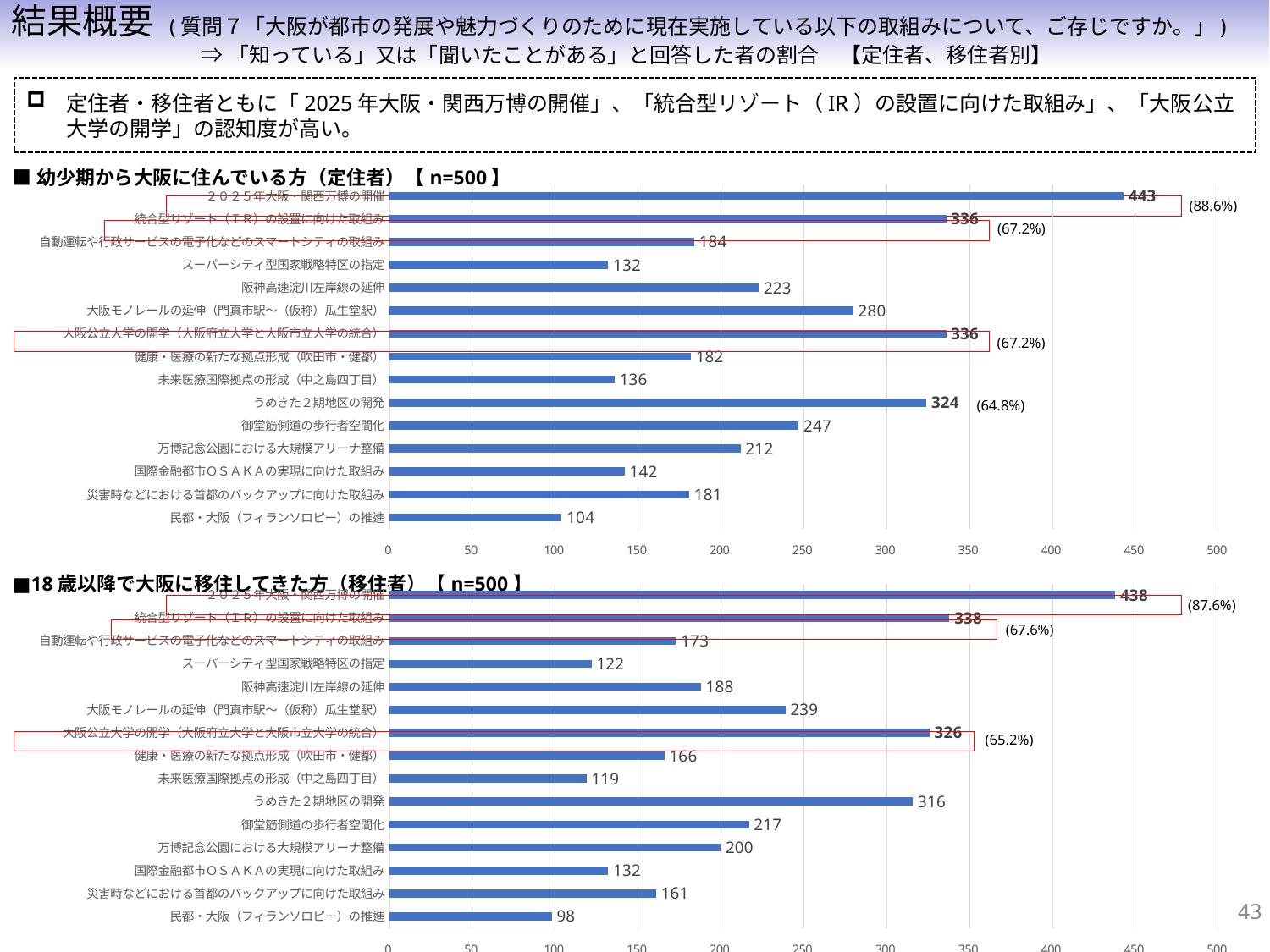
In the bottom chart (移住者), is the value for 万博記念公園における大規模アリーナ整備 greater or less than 150? greater What type of chart is used on this slide? Bar chart In the bottom chart (移住者), what is the value for 大阪公立大学の開学? 326 In the top chart (定住者), what is the difference between 大阪モノレールの延伸 (280) and 阪神高速淀川左岸線の延伸 (223)? 57 In the top chart (定住者), what is the value for 2025年大阪・関西万博の開催? 443 In the bottom chart (移住者), which category has the highest value? 2025年大阪・関西万博の開催 In the bottom chart (移住者), what is the value for 民都・大阪（フィランソロピー）の推進? 98 What percentage is shown next to the 2025年大阪・関西万博の開催 bar in the bottom chart (移住者)? (87.6%) In the top chart (定住者), how many categories are plotted? 15 In the top chart (定住者), which is larger: うめきた２期地区の開発 or 御堂筋側道の歩行者空間化? うめきた２期地区の開発 In the bottom chart (移住者), what is the difference between 統合型リゾート（IR）の設置に向けた取組み (338) and うめきた２期地区の開発 (316)? 22 In the top chart (定住者), which category has the lowest value? 民都・大阪（フィランソロピー）の推進